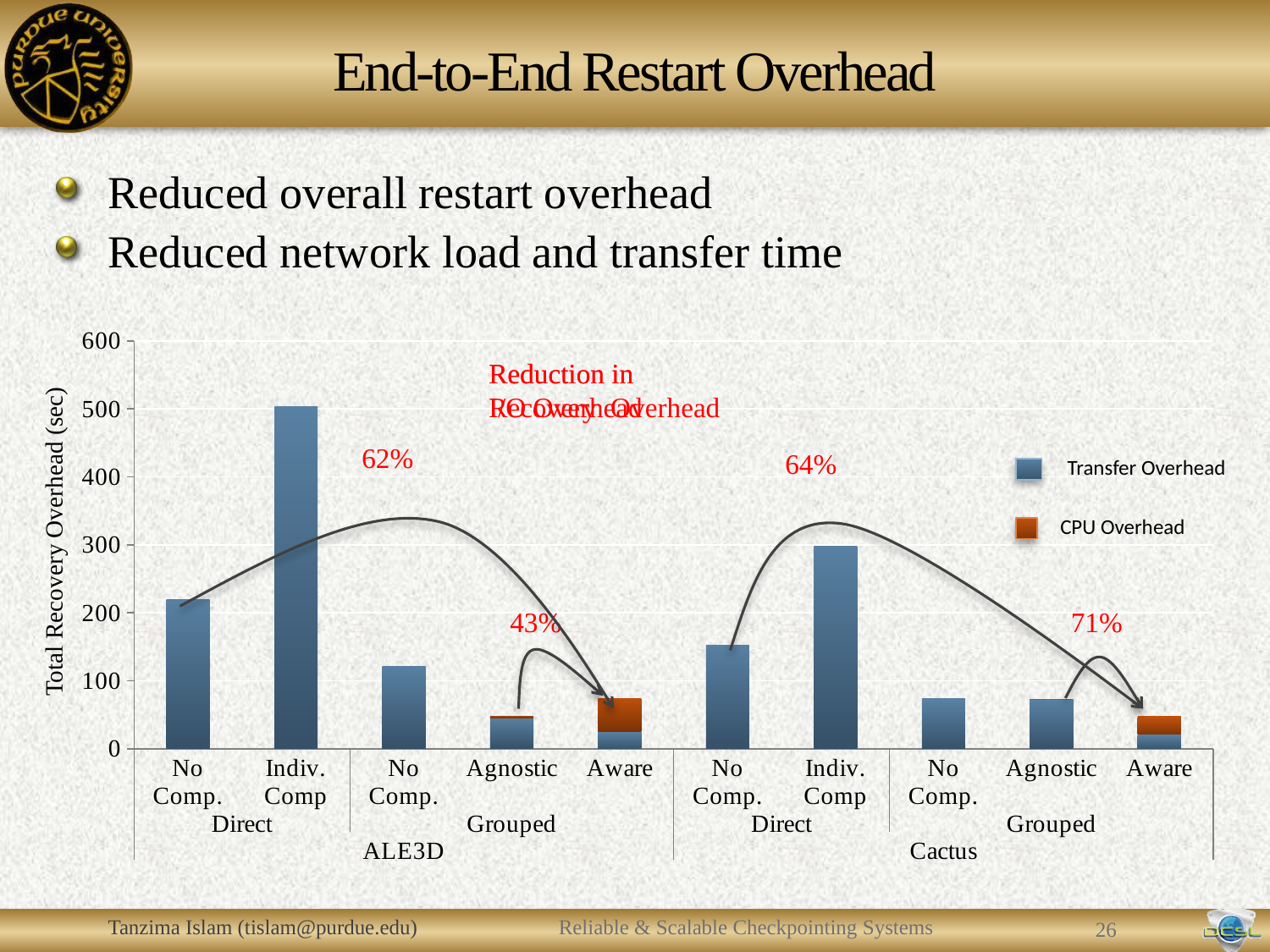
What is the label of the vertical axis of the chart? Total Recovery Overhead (sec) Is the value for ALE3D Direct No Comp. greater or less than 200? greater How many series does the chart legend list? 2 Which bar has the highest total recovery overhead? ALE3D Direct Indiv. Comp What kind of chart is shown on the slide? bar chart What are the two series named in the chart legend? Transfer Overhead and CPU Overhead Is the value for Cactus Direct No Comp. greater or less than 200? less Is the value for Cactus Grouped No Comp. greater or less than 100? less How many bars are plotted in the chart? 10 What reduction in recovery overhead is annotated for the Cactus Grouped Aware bar relative to Grouped Agnostic? 71% Which is larger, the total for ALE3D Direct Indiv. Comp or Cactus Direct Indiv. Comp? ALE3D Direct Indiv. Comp